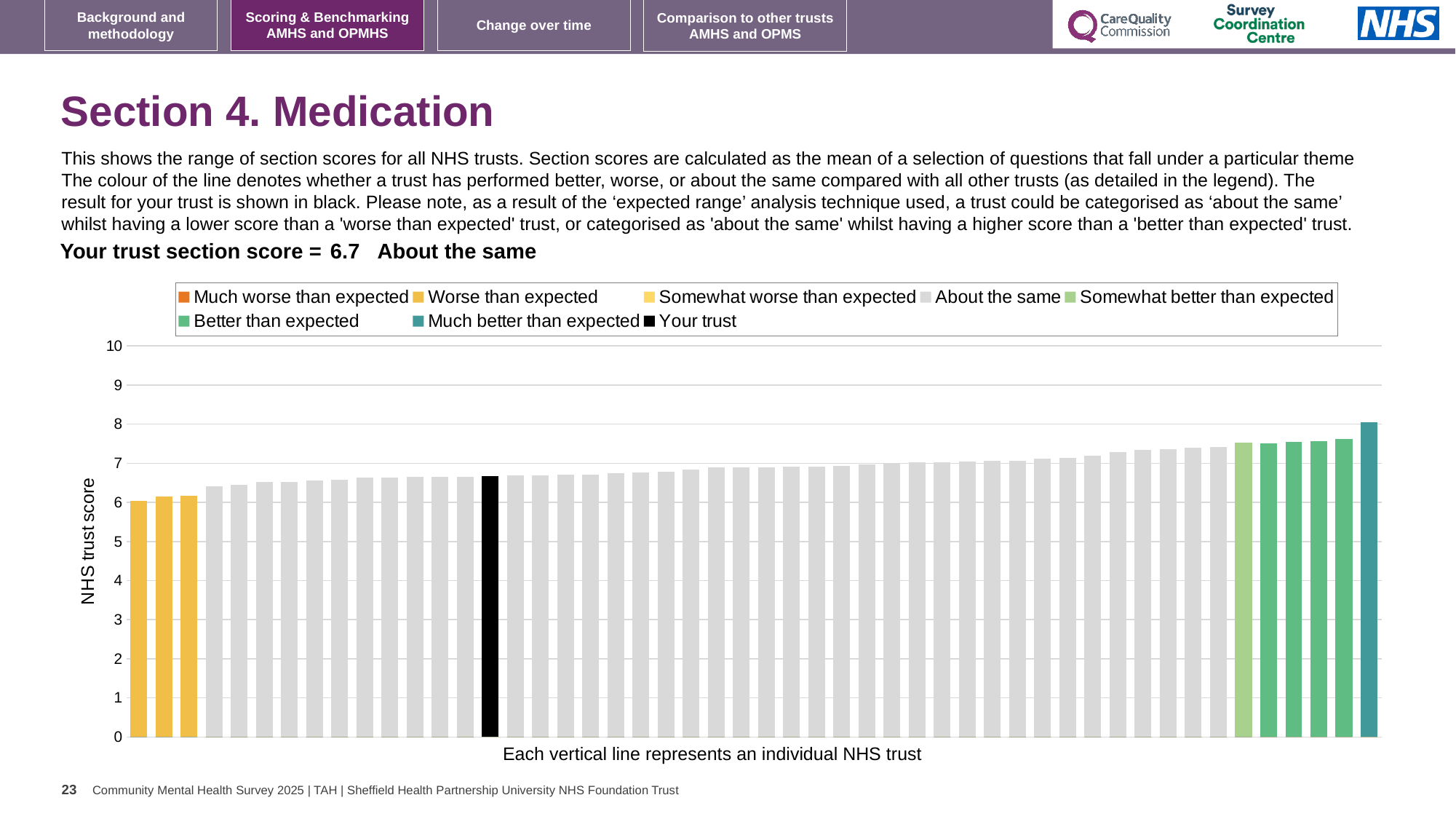
Which performance category is your trust placed in for Section 4. Medication? About the same What kind of chart is shown on the slide? Bar chart Do the bar values rise or fall moving from left to right along the x axis? Rise What is the label on the vertical axis of the chart? NHS trust score Is the value for your trust's bar greater or less than 5? greater What is your trust's section score for Section 4. Medication? 6.7 How many bars are coloured as 'Worse than expected'? 3 How many entries does the chart legend list? 8 What colour is the bar representing your trust? Black Is the value of the tallest bar on the chart greater or less than 7? greater Is the value of the lowest bar on the chart greater or less than 7? less Which legend category does the trust with the highest score belong to? Much better than expected